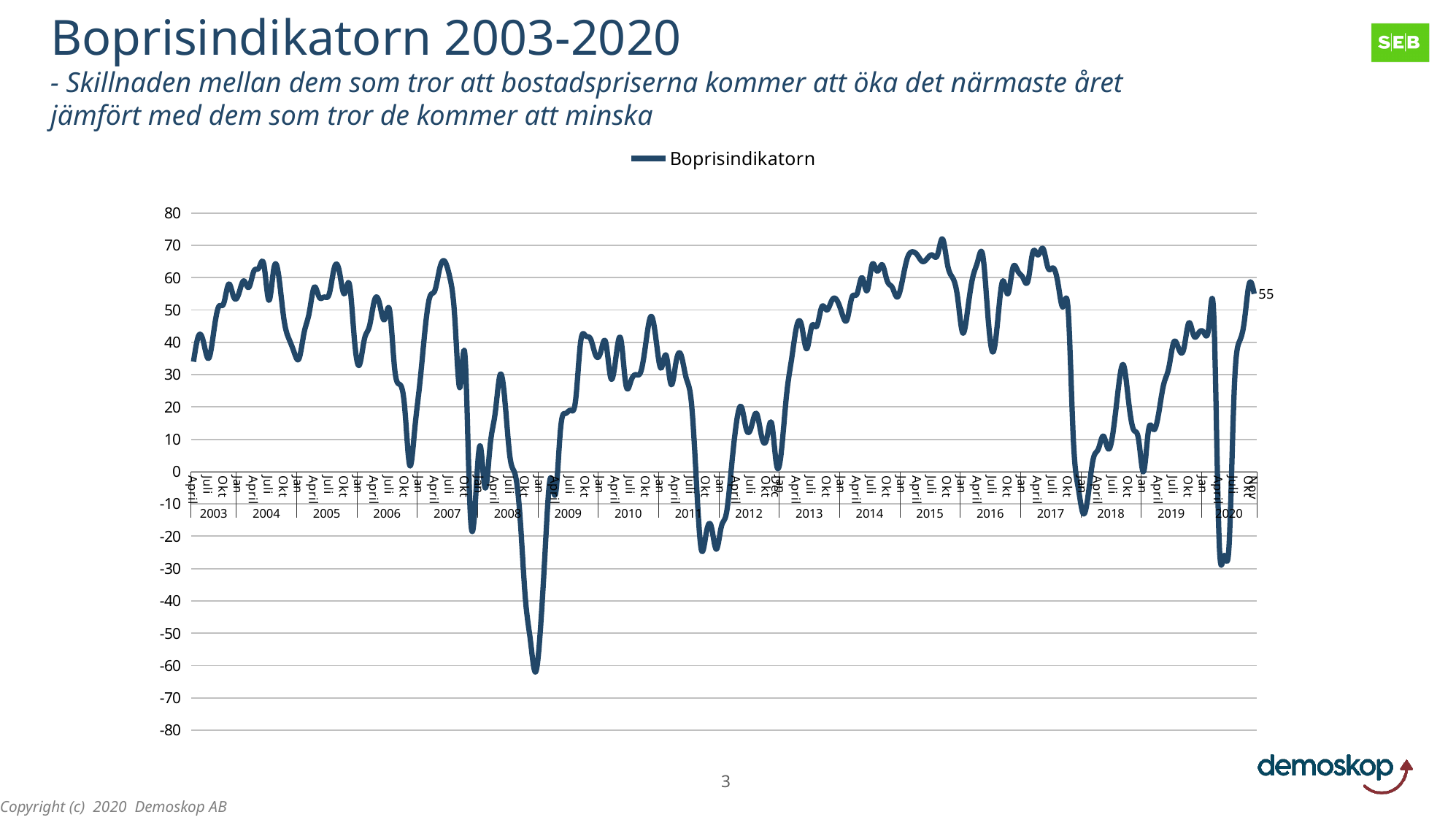
How many series does the legend list? 1 Is the lowest value of the line, in early 2009, greater or less than -50? less What type of chart is shown on the slide? line chart What is the name of the series shown in the legend? Boprisindikatorn Is the highest value of the line, reached in 2015, greater or less than 60? greater What is the title of the chart on the slide? Boprisindikatorn 2003-2020 Is the value in Jan 2018 greater or less than 0? less What is the value of the last data point (Nov 2020) shown with a data label? 55 Does the line generally rise or fall from the start of 2013 to the end of 2015? rise How many years are labelled along the x axis? 18